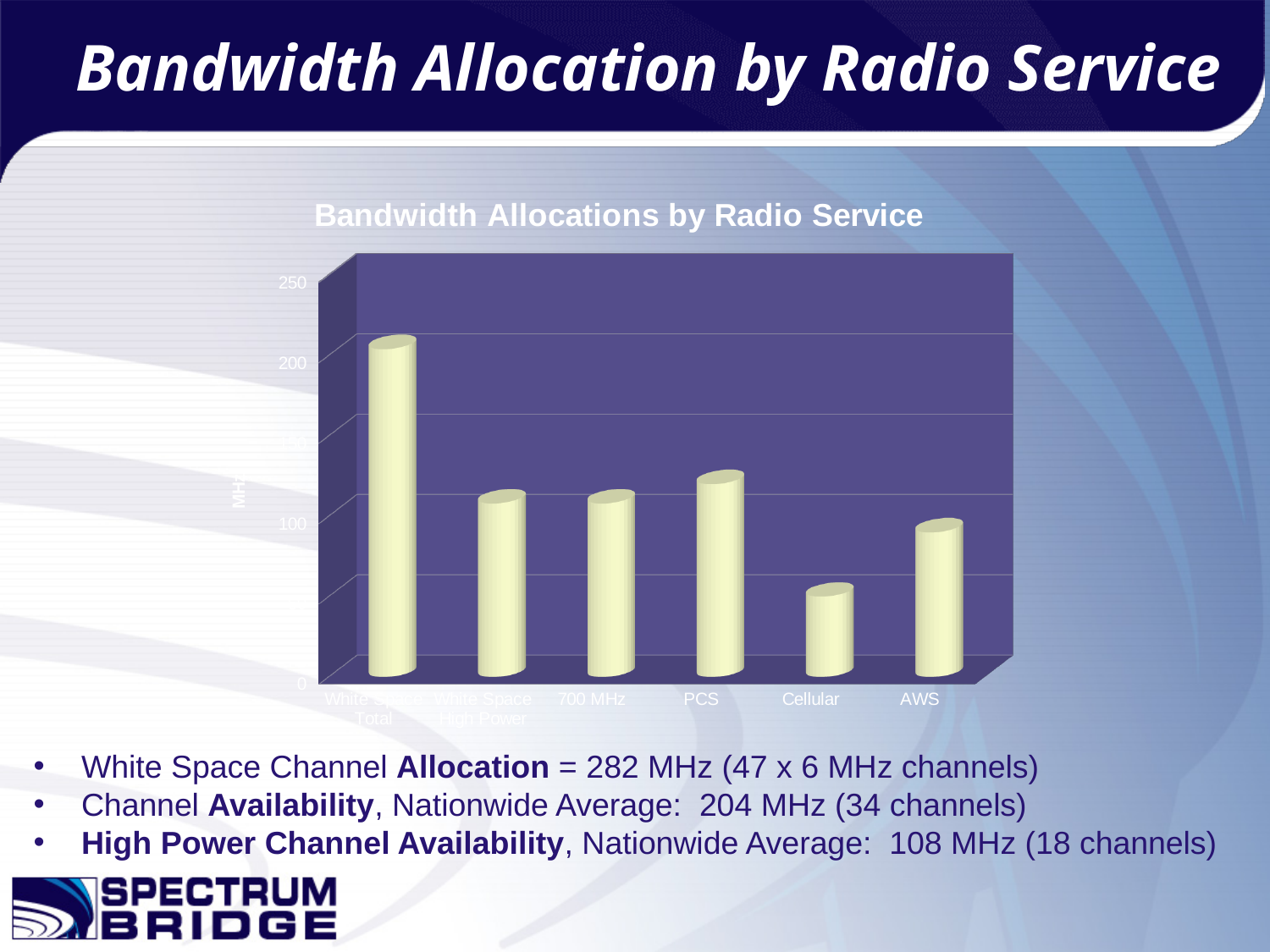
What kind of chart is shown on the slide? bar chart Which is larger, the value for Cellular or the value for AWS? AWS How many radio service categories are plotted on the x axis? 6 Which radio service has the highest bandwidth allocation? White Space Total What is the title of the chart? Bandwidth Allocations by Radio Service Which is larger, the value for White Space Total or the value for PCS? White Space Total What unit is shown on the vertical axis label? MHz Is the value for White Space Total greater or less than 150? greater Is the value for PCS greater or less than 100? greater Is the value for AWS greater or less than 50? greater Which radio service has the lowest bandwidth allocation? Cellular